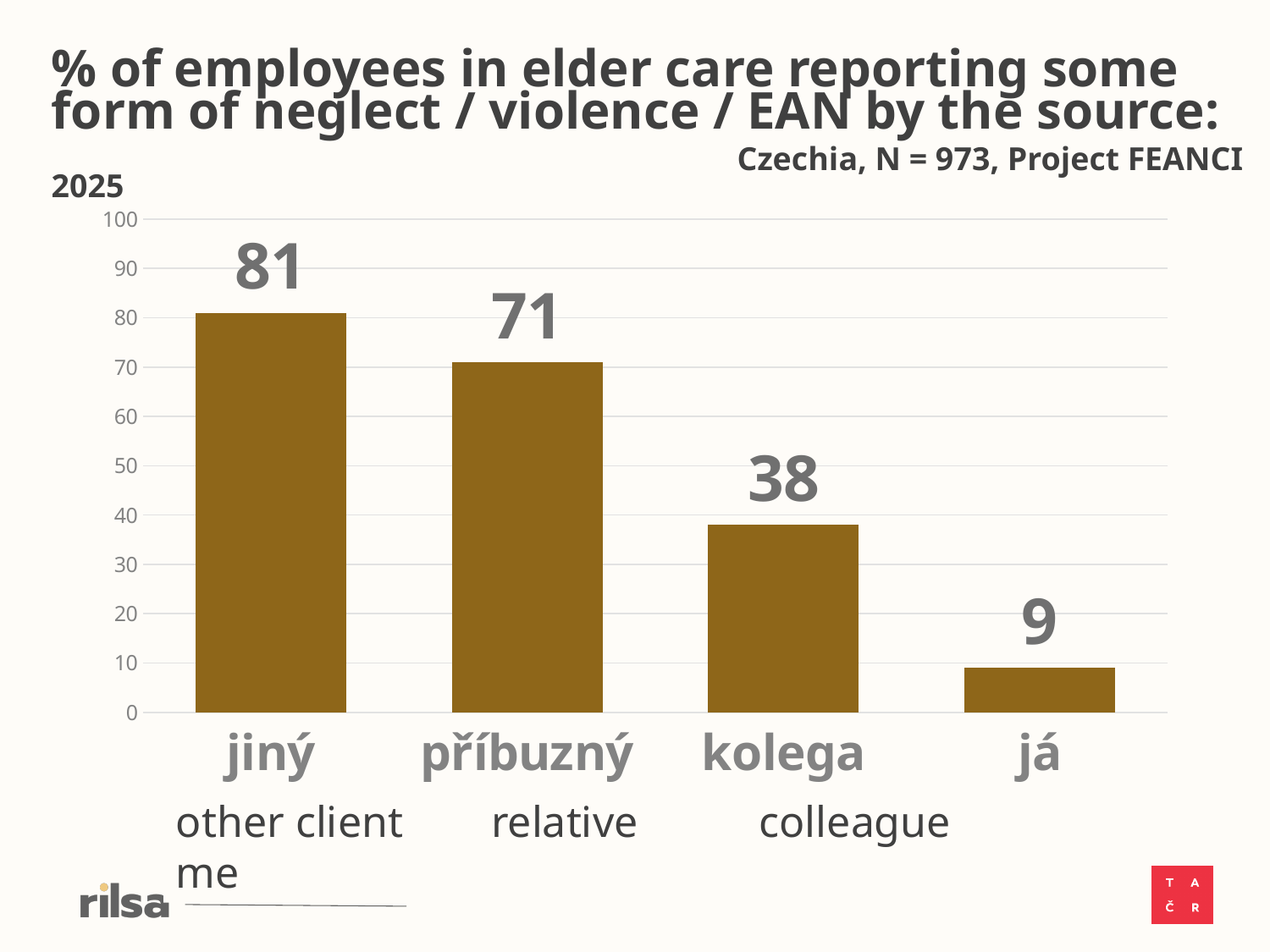
Which is larger, the value for příbuzný or the value for kolega? příbuzný What is the value for příbuzný (relative)? 71 What is the value for já (me)? 9 What is the value for kolega (colleague)? 38 Which category has the lowest value? já (me) Do the values rise or fall from left to right along the x axis? fall What is the value for jiný (other client)? 81 Which category has the highest value? jiný (other client) What is the difference between the values for jiný and příbuzný? 10 How many categories are shown on the chart? 4 What kind of chart is shown on the slide? bar chart What is the difference between the values for kolega and já? 29